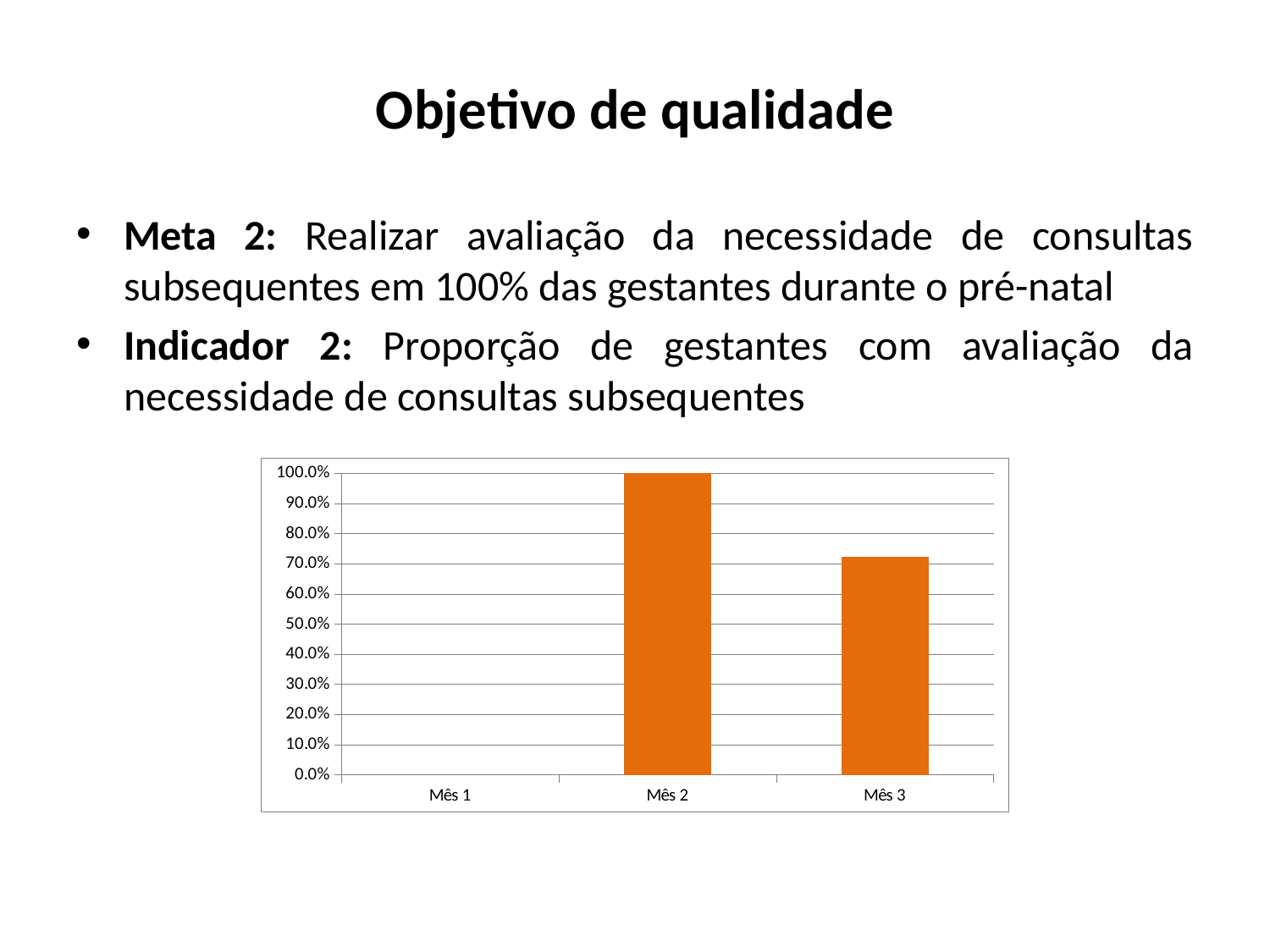
What kind of chart is shown on the slide? bar chart What is the value for Mês 2? 100.0% How many categories are shown on the x axis of the chart? 3 Is the value for Mês 3 greater or less than 60.0%? greater Which is larger, the value for Mês 2 or the value for Mês 3? Mês 2 Does the value rise or fall from Mês 2 to Mês 3? fall Which month has the lowest value in the chart? Mês 1 What colour are the bars in the chart? orange Which month has the highest value in the chart? Mês 2 What is the highest value shown on the y axis of the chart? 100.0% Is the value for Mês 3 greater or less than 80.0%? less